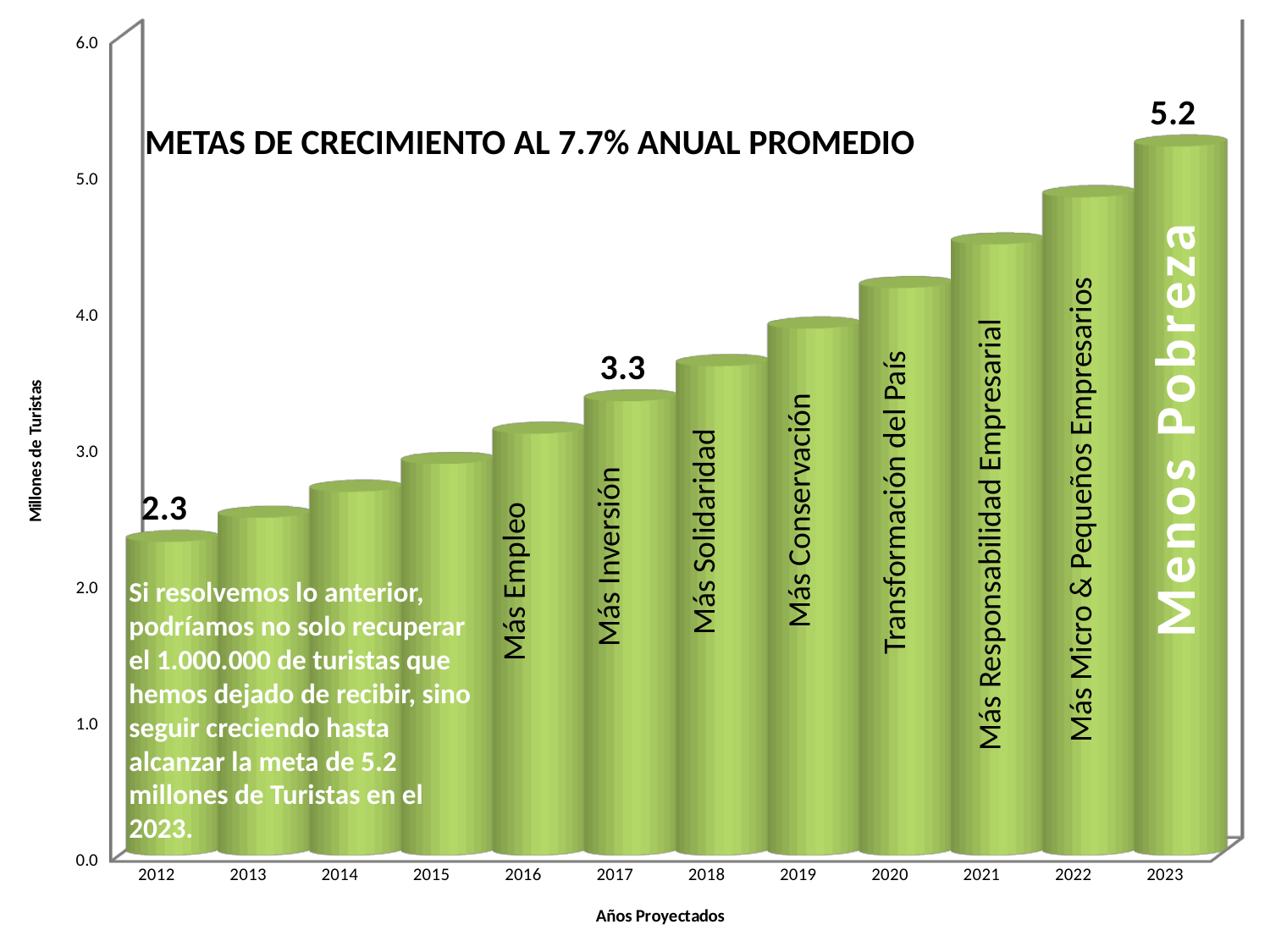
What is the difference between the values for 2023 and 2012? 2.9 What is the value for 2012? 2.3 Which year has the lowest value? 2012 What type of chart is shown on the slide? bar chart Is the value for 2014 greater or less than 3.0? less What is the difference between the values for 2017 and 2012? 1.0 What is the value for 2017? 3.3 How many years are shown on the x axis? 12 Is the value for 2022 greater or less than 5.0? less What is the value for 2023? 5.2 Which year has the highest value? 2023 Do the values rise or fall from 2012 to 2023? rise